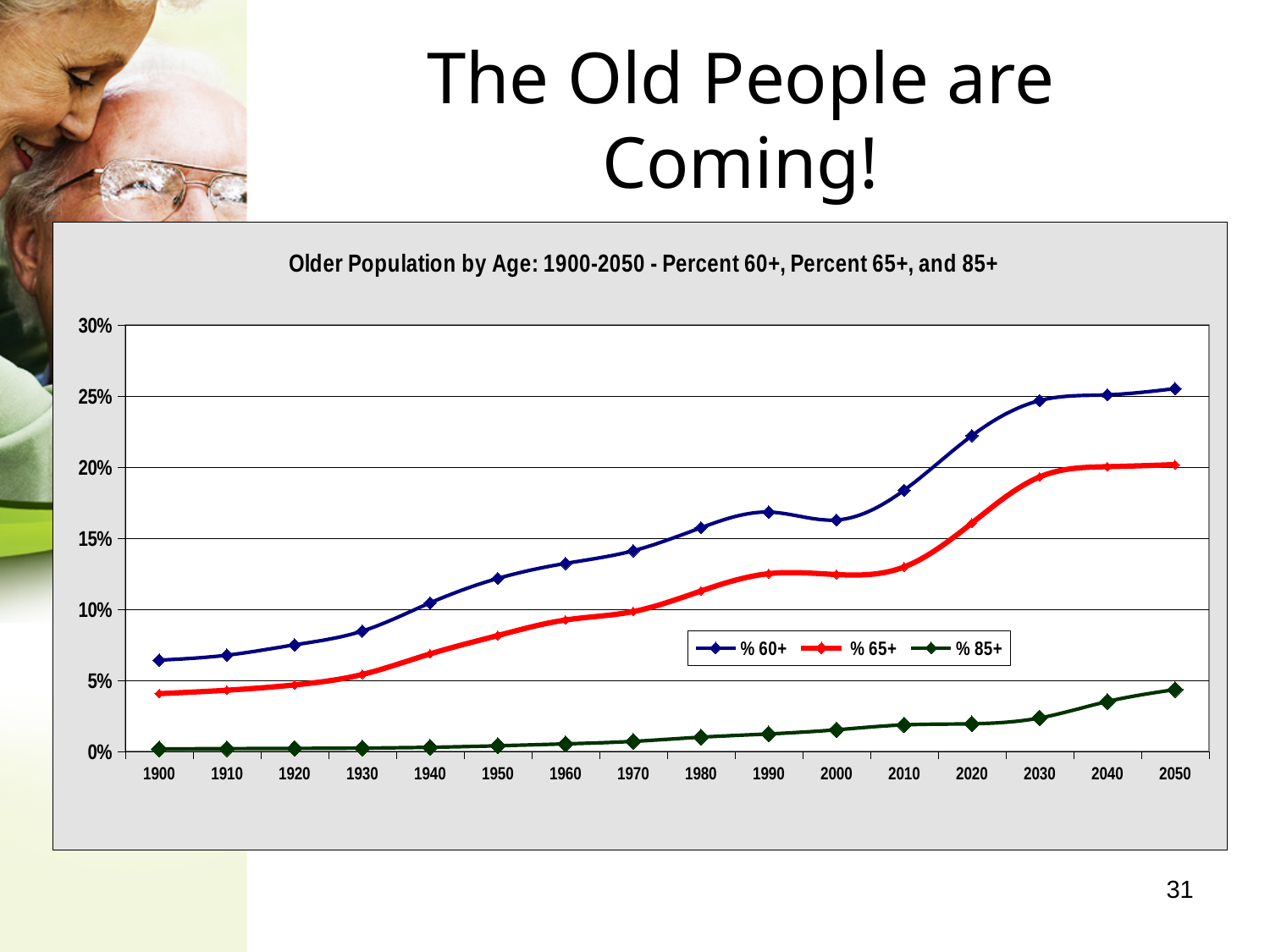
How many years are plotted along the x axis? 16 Is the value for % 65+ in 2000 greater or less than 10%? greater What is the title of the chart? Older Population by Age: 1900-2050 - Percent 60+, Percent 65+, and 85+ Is the value for % 85+ in 2050 greater or less than 5%? less What kind of chart is shown on the slide? line chart Which series has the lowest values across the chart? % 85+ How many series does the legend list? 3 Which series is drawn in red? % 65+ Do the values for % 65+ generally rise or fall from 1900 to 2050? rise Is the value for % 60+ in 2020 greater or less than 20%? greater In which year is the % 60+ series at its lowest? 1900 Which series has the highest values across the chart? % 60+